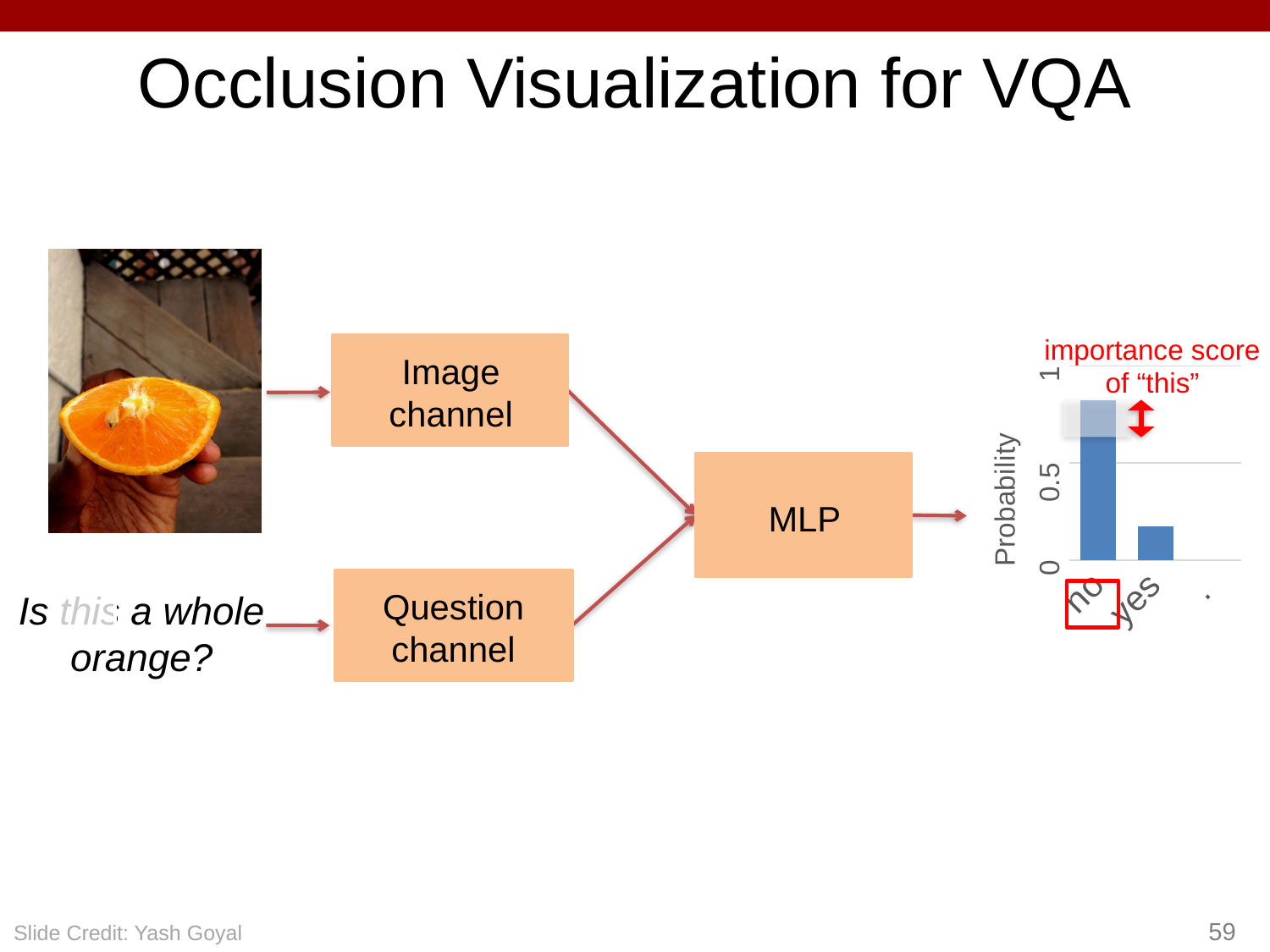
Which category has the lowest probability in the bar chart? yes What does the red annotation above the bar chart say the red arrow represents? importance score of "this" What is the label on the vertical axis of the bar chart? Probability Which category has the highest probability in the bar chart? no Which has a larger probability in the bar chart, "no" or "yes"? no Is the probability for "yes" greater or less than 0.5? less What kind of chart is shown on the right of the slide? bar chart Is the probability for "no" greater or less than 0.5? greater